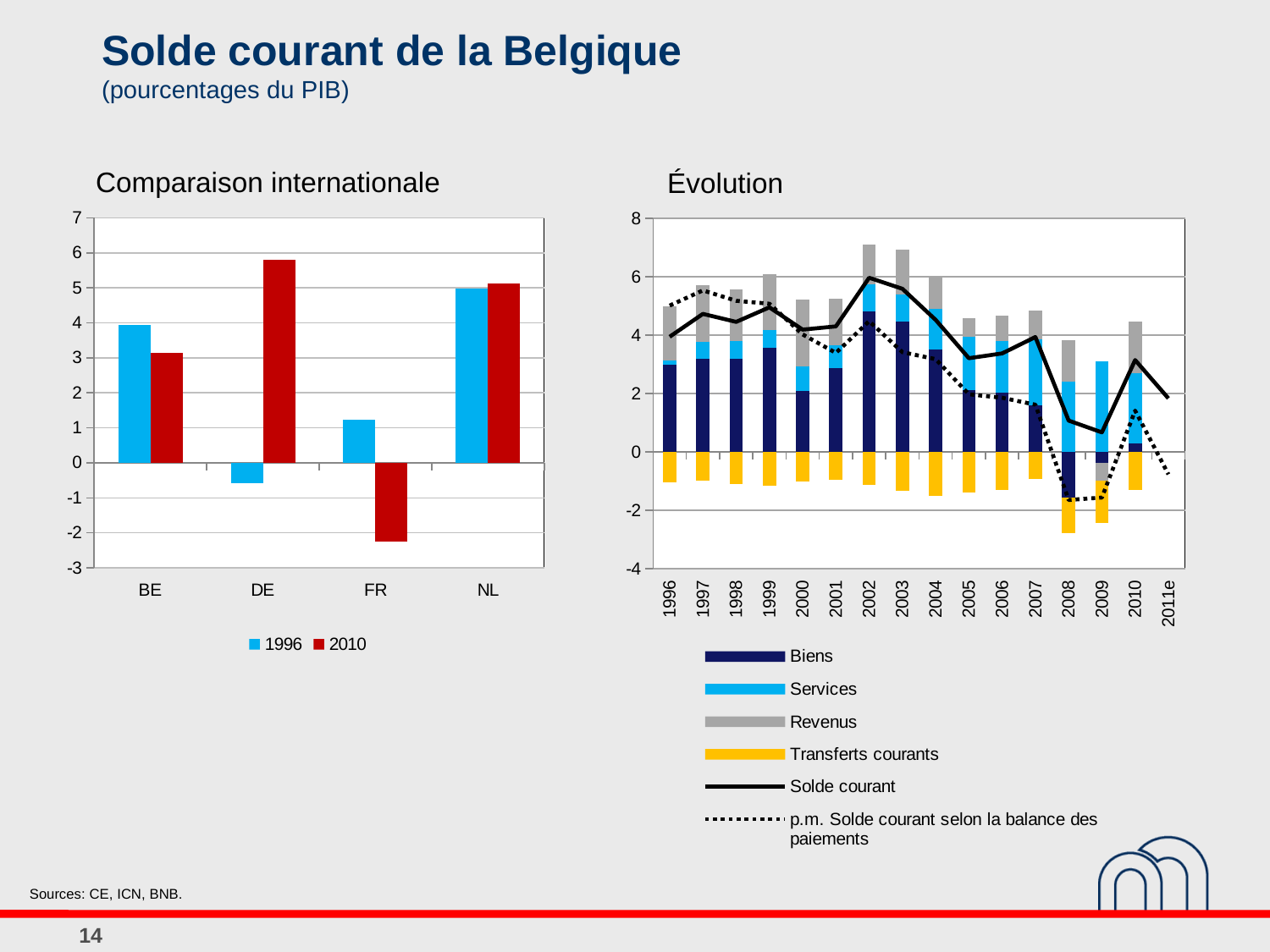
In the 'Comparaison internationale' chart, how many countries are shown on the x axis? 4 In the 'Comparaison internationale' chart, how many series does the legend list? 2 In the 'Comparaison internationale' chart, which is larger for BE: the 1996 value or the 2010 value? 1996 In the 'Évolution' chart, how many entries does the legend list? 6 In the 'Évolution' chart, how many years are shown on the x axis? 16 In the 'Comparaison internationale' chart, which country has the lowest value for 2010? FR In the 'Évolution' chart, is the 'Solde courant' line value for 2002 greater or less than 4? greater In the 'Comparaison internationale' chart, is the 2010 value for DE greater or less than 5? greater In the 'Comparaison internationale' chart, which country has the lowest value for 1996? DE In the 'Comparaison internationale' chart, which country has the highest value for 2010? DE In the 'Comparaison internationale' chart, is the 2010 value for FR greater or less than -2? less In the 'Comparaison internationale' chart, what kind of chart is shown? bar chart